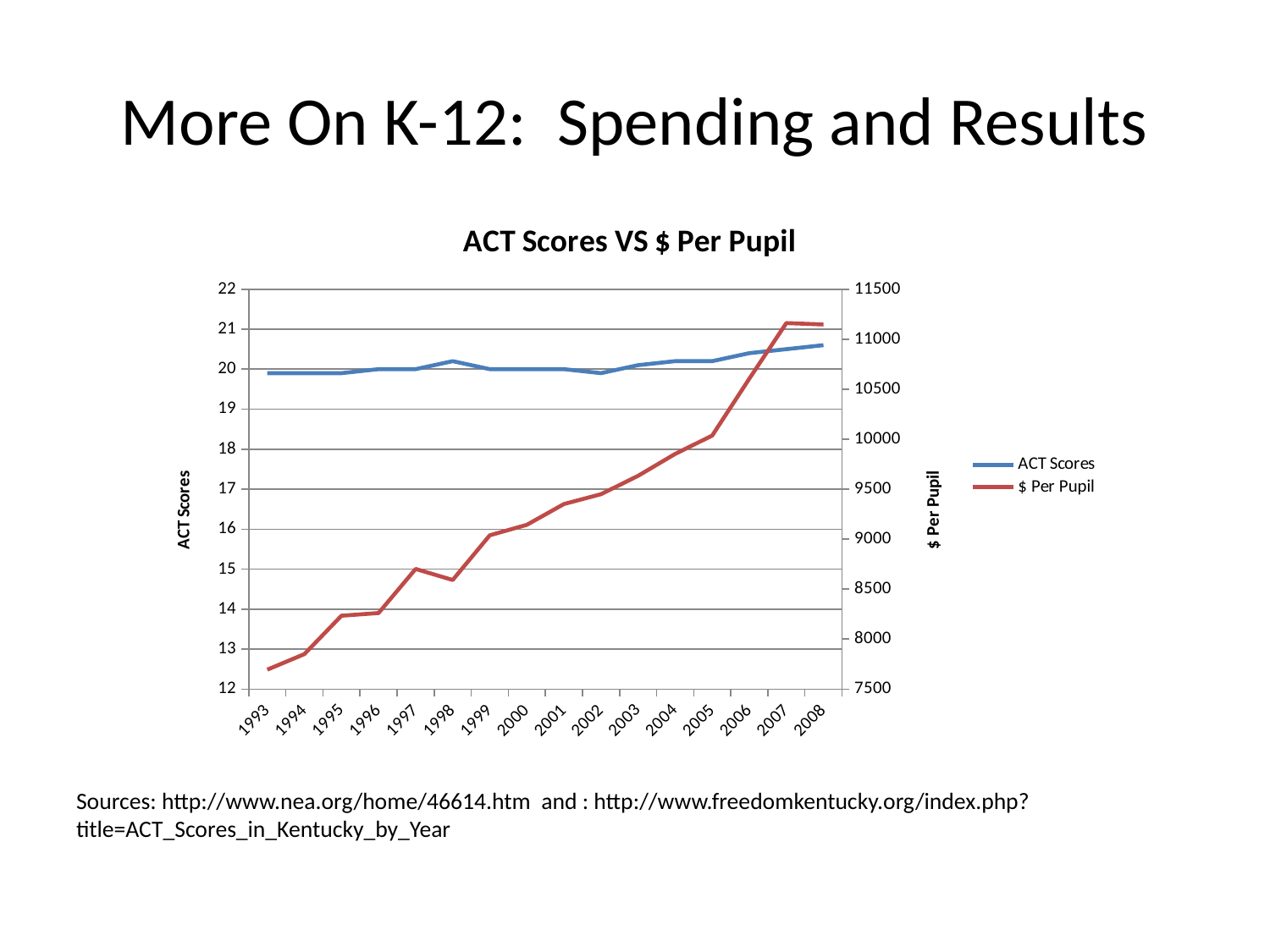
Is the $ Per Pupil value for 2004 greater or less than 10000? less Do the $ Per Pupil values generally rise or fall from 1993 to 2008? Rise Is the ACT Scores value for 2008 greater or less than 20? greater Which year has the larger $ Per Pupil value, 1993 or 2008? 2008 Is the $ Per Pupil value for 1993 greater or less than 8000? less Which series is drawn in red? $ Per Pupil In which year is the $ Per Pupil value lowest? 1993 How many series does the legend list? 2 What kind of chart is shown on the slide? Line chart How many years are plotted along the x axis? 16 What is the title of the chart? ACT Scores VS $ Per Pupil